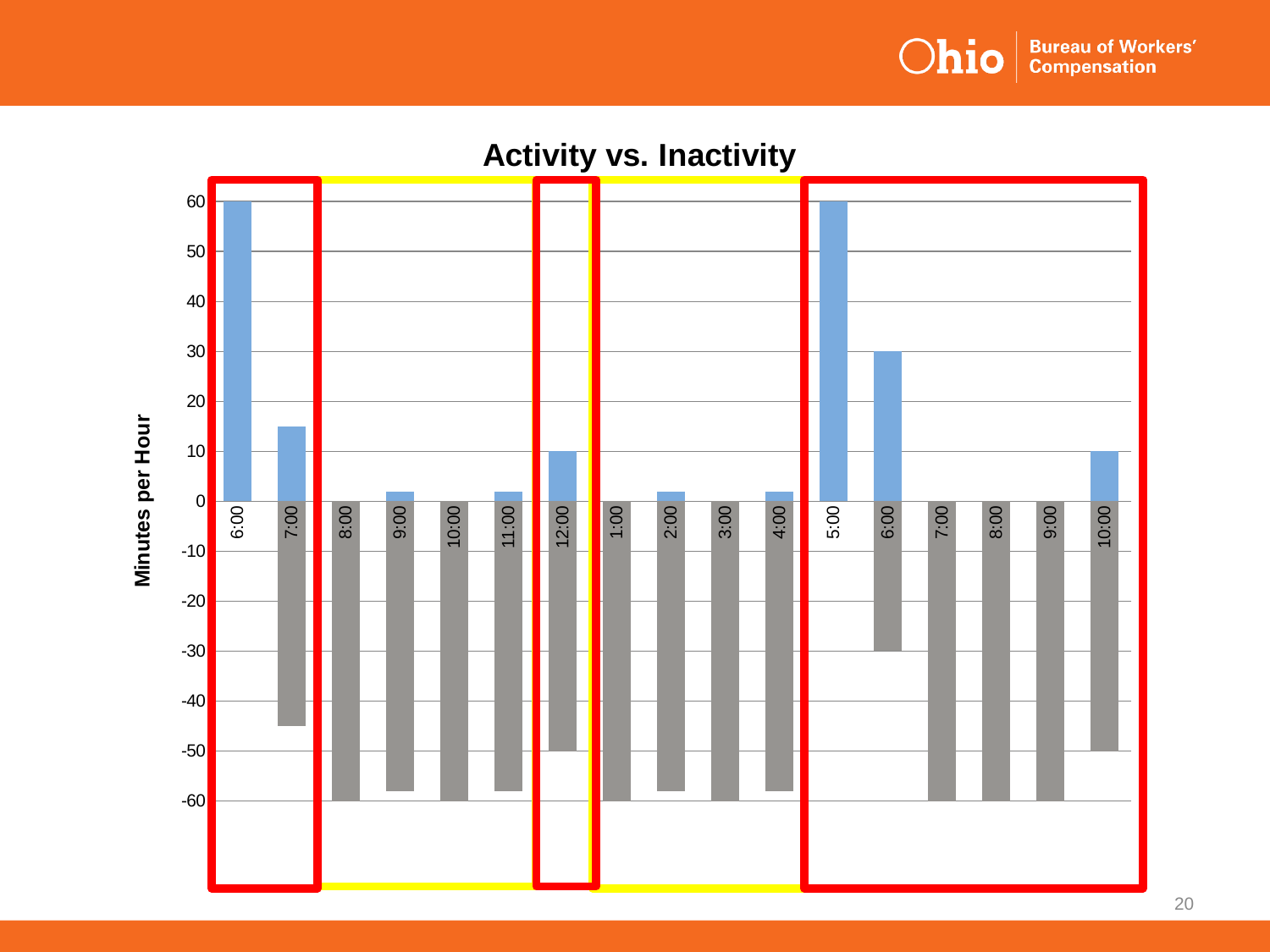
What is the value of the blue bar at the second 6:00 category (right after 5:00)? 30 What is the value of the gray bar at 8:00 (the first 8:00, on the left side)? -60 What kind of chart is shown on the slide? bar chart What is the label on the vertical axis of the chart? Minutes per Hour What is the value of the gray bar at the last 10:00 category (rightmost)? -50 What is the value of the blue bar at the first 6:00 category (leftmost)? 60 What is the value of the blue bar at 12:00? 10 What is the title of the chart? Activity vs. Inactivity What is the value of the blue bar at 5:00? 60 Is the value of the blue bar at the first 7:00 category greater or less than 10? greater How many time categories are shown along the x axis of the chart? 17 Which blue bar is taller, the one at the first 6:00 category or the one at the first 7:00 category? 6:00